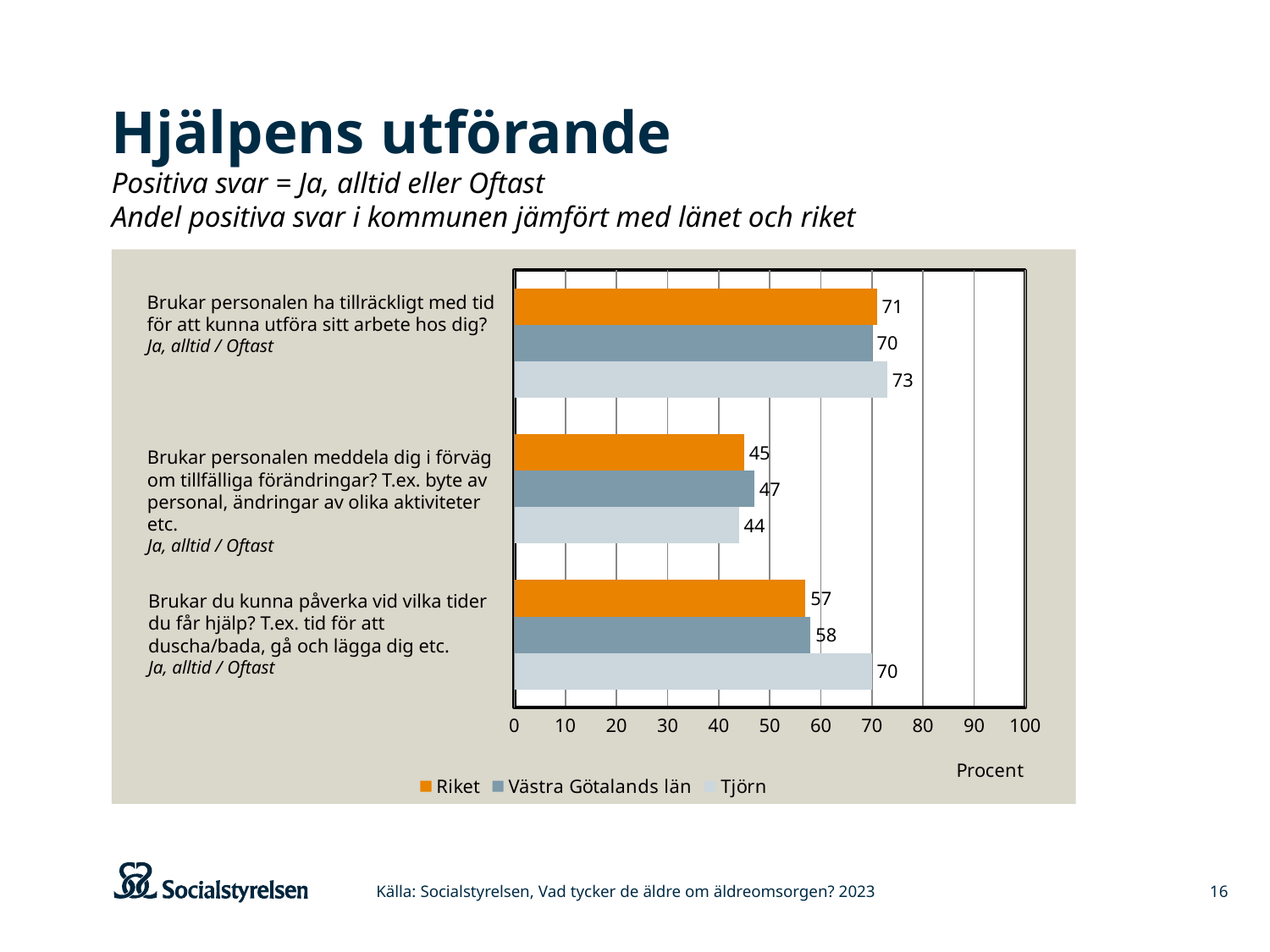
What kind of chart is shown on the slide? Bar chart Which series has the lowest value on the question 'Brukar personalen meddela dig i förväg om tillfälliga förändringar?' Tjörn What is the value for Västra Götalands län on the question 'Brukar du kunna påverka vid vilka tider du får hjälp?' 58 What is the value for Tjörn on the question 'Brukar personalen ha tillräckligt med tid för att kunna utföra sitt arbete hos dig?' 73 How many series does the legend list? 3 Which series has the highest value on the question 'Brukar du kunna påverka vid vilka tider du får hjälp?' Tjörn Which question category has the lowest value for Riket? Brukar personalen meddela dig i förväg om tillfälliga förändringar? What unit label is shown under the x axis of the chart? Procent What is the value for Riket on the question 'Brukar personalen meddela dig i förväg om tillfälliga förändringar?' 45 How many question categories are plotted on the chart? 3 What is the difference between Tjörn and Riket on the question 'Brukar du kunna påverka vid vilka tider du får hjälp?' 13 Which is larger on the question 'Brukar personalen meddela dig i förväg om tillfälliga förändringar?': Västra Götalands län or Tjörn? Västra Götalands län